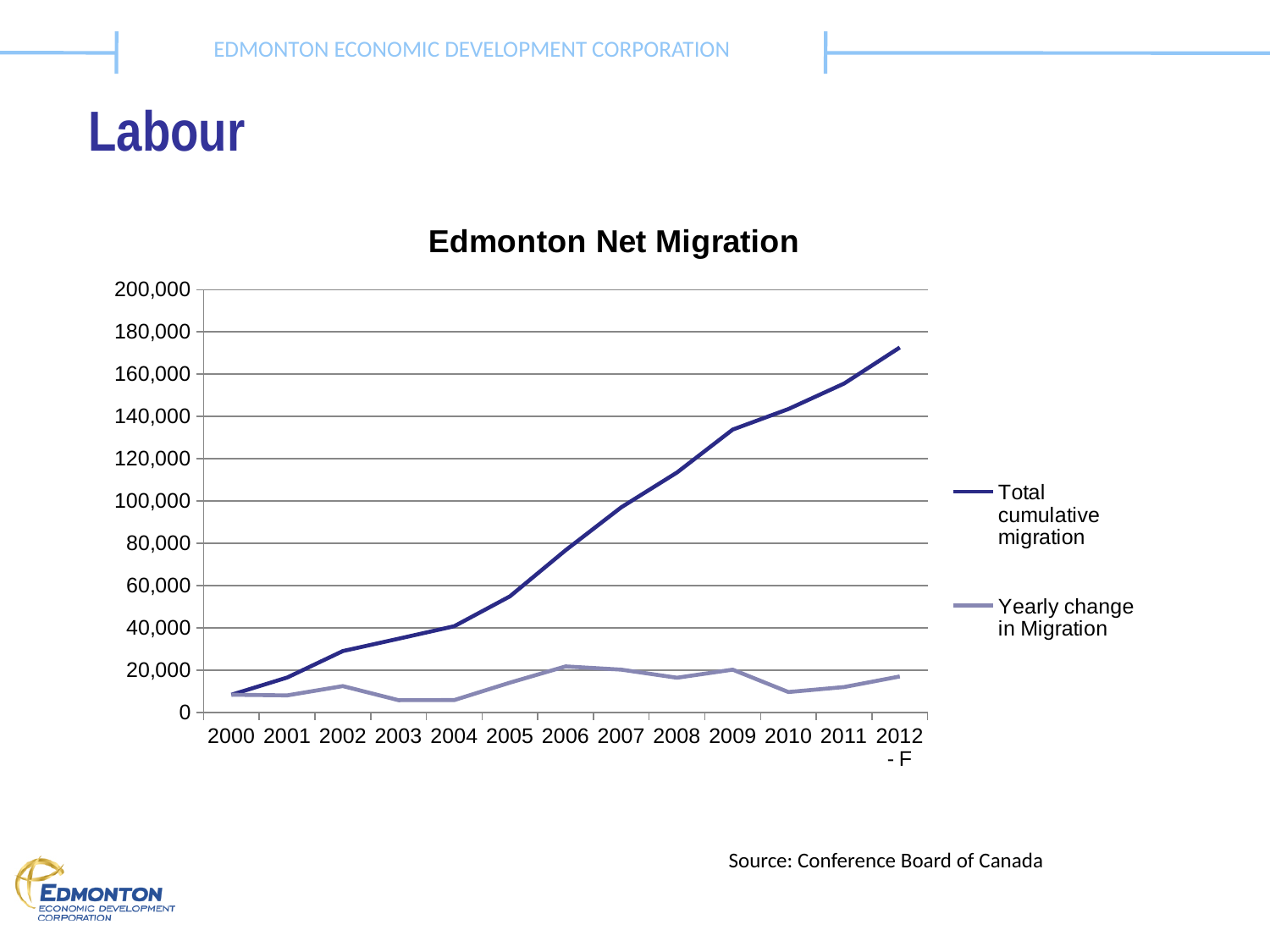
Is the value for Total cumulative migration in 2009 greater or less than 120,000? greater Does the Total cumulative migration line rise or fall from 2000 to 2012-F? rise In which year is Total cumulative migration highest? 2012 - F Which series is drawn with the darker line? Total cumulative migration Is the value for Total cumulative migration in 2012-F greater or less than 160,000? greater What is the title of the chart? Edmonton Net Migration What kind of chart is shown on the slide? line chart In which year is Total cumulative migration lowest? 2000 Which is larger: Yearly change in Migration in 2006 or in 2010? 2006 Is the value for Yearly change in Migration in 2010 greater or less than 20,000? less How many series does the legend list? 2 How many years are plotted along the x axis? 13